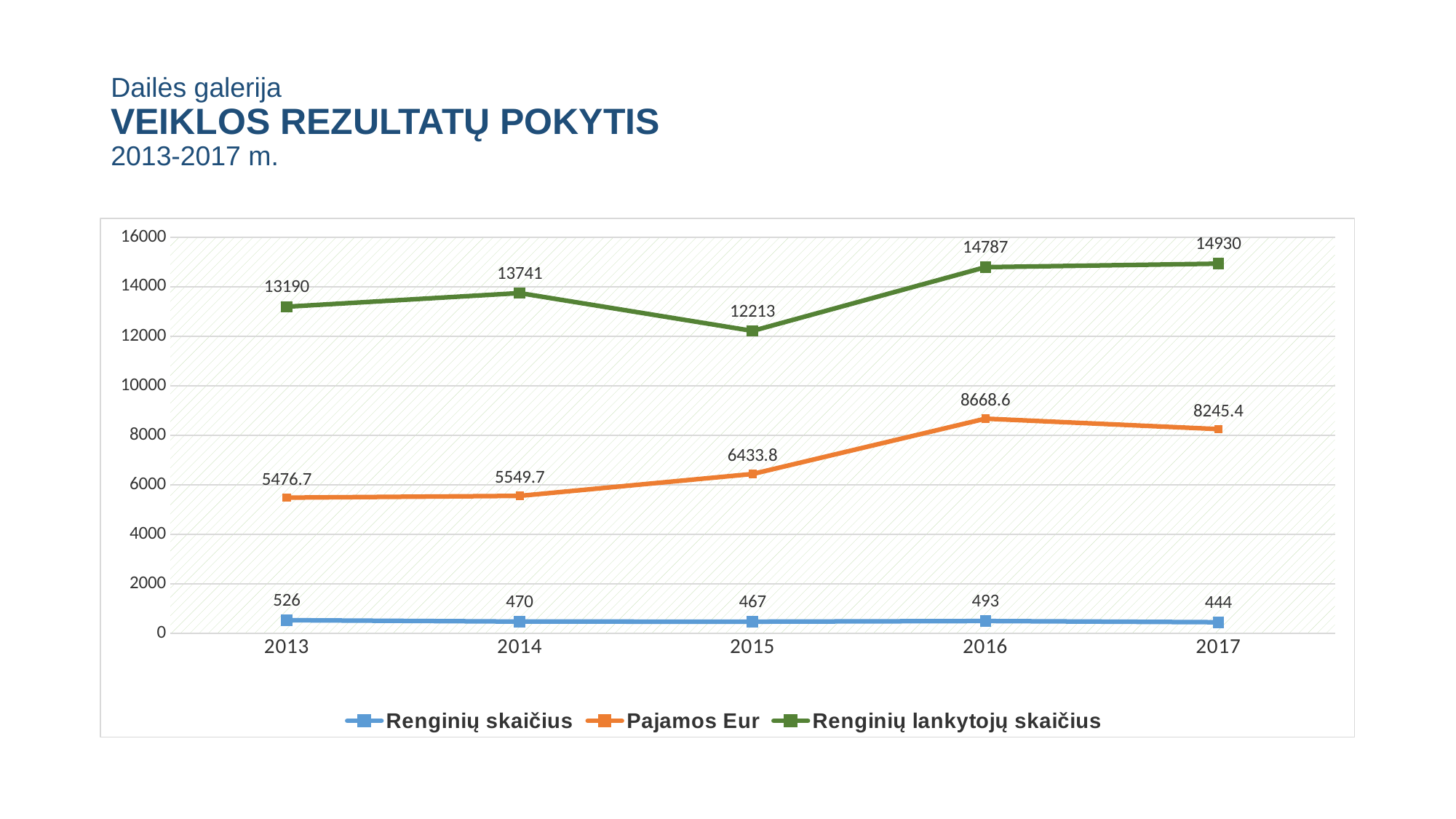
What is the value of Pajamos Eur in 2016? 8668.6 What is the value of Renginių skaičius in 2013? 526 Which is larger: Pajamos Eur in 2014 or in 2015? 2015 In which year is Renginių lankytojų skaičius highest? 2017 Does Pajamos Eur rise or fall from 2013 to 2016? rise What is the difference between Renginių lankytojų skaičius in 2017 and 2016? 143 How many years are shown on the x axis? 5 What kind of chart is shown on the slide? line chart In which year is Renginių skaičius lowest? 2017 What is the value of Renginių lankytojų skaičius in 2015? 12213 How many series does the legend list? 3 Is the value of Pajamos Eur in 2017 greater or less than 8000? greater